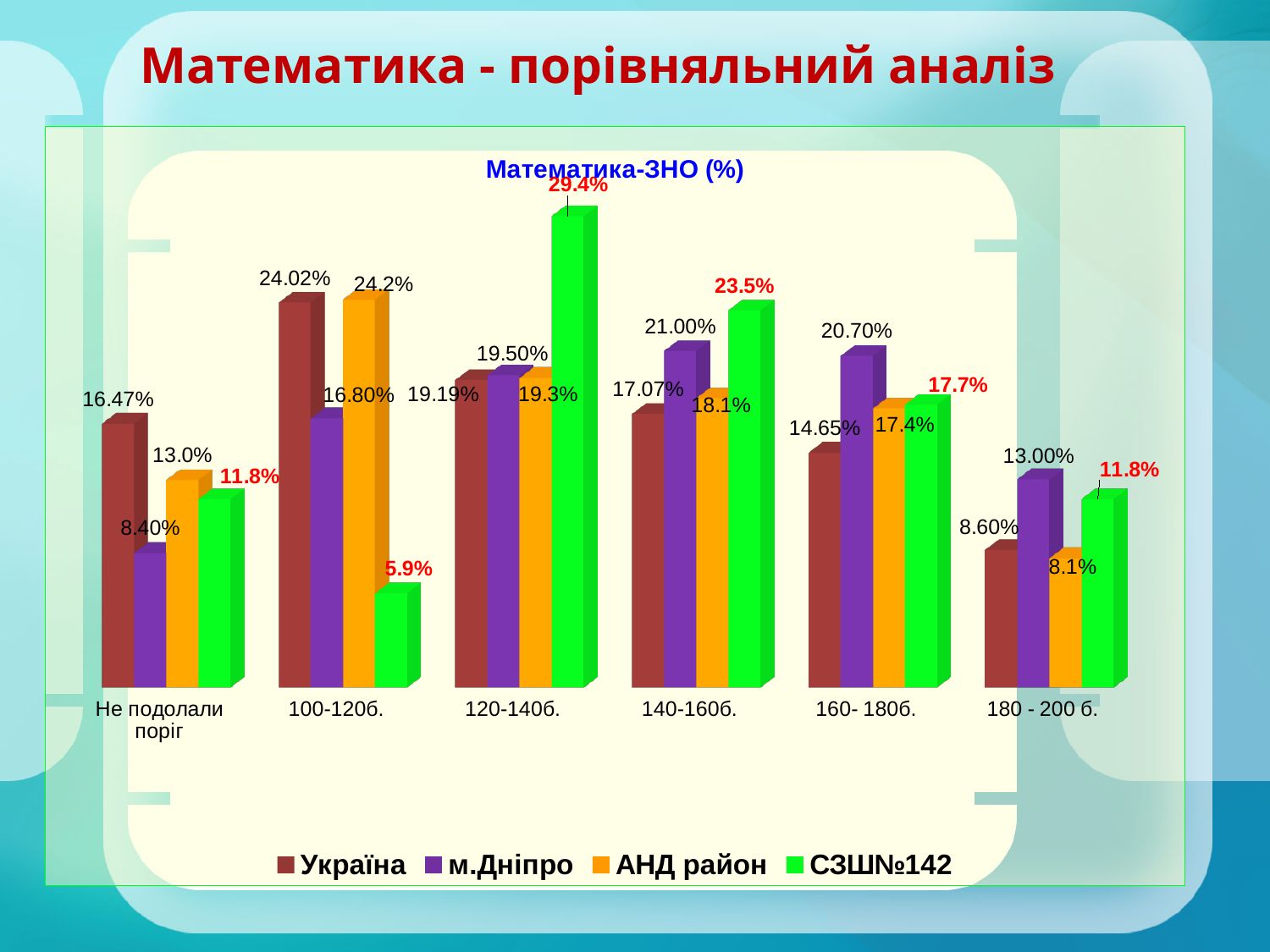
What is the difference between the СЗШ№142 value and the Україна value in the 140-160б. category? 6.43% In which category does СЗШ№142 have its highest value? 120-140б. How many score categories are shown on the x axis? 6 How many series does the legend list? 4 What is the value for Україна in the 100-120б. category? 24.02% What is the value for м.Дніпро in the 'Не подолали поріг' category? 8.40% What is the value for СЗШ№142 in the 120-140б. category? 29.4% In which category does СЗШ№142 have its lowest value? 100-120б. Which is larger in the 180 - 200 б. category: м.Дніпро or СЗШ№142? м.Дніпро What is the value for АНД район in the 160- 180б. category? 17.4% What is the title of the chart? Математика-ЗНО (%) What type of chart is shown on the slide? Bar chart